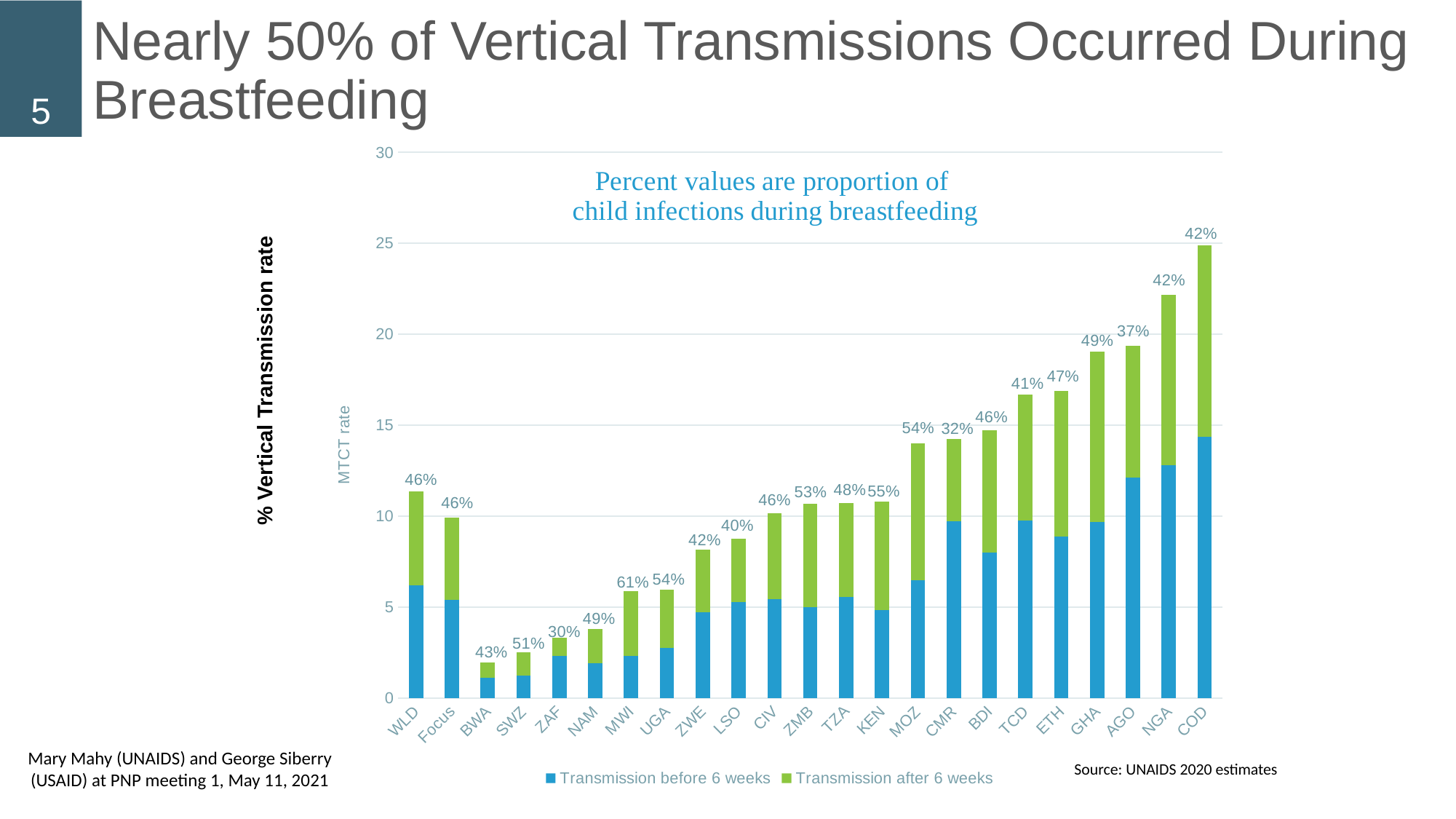
What kind of chart is shown on the slide? Stacked bar chart How many countries/categories are shown on the x axis? 23 Which has the taller total bar, COD or WLD? COD Is the total MTCT rate bar for BWA greater or less than 5? less What percent label is shown above the bar for ZAF? 30% Is the total MTCT rate bar for COD greater or less than 20? greater Which country has the highest percent label (proportion of child infections during breastfeeding)? MWI What percent label is shown above the bar for MWI? 61% What is the difference between the percent labels for MWI and ZAF? 31 percentage points How many series does the legend list? 2 What percent label is shown above the bar for COD? 42% Which country has the lowest percent label (proportion of child infections during breastfeeding)? ZAF